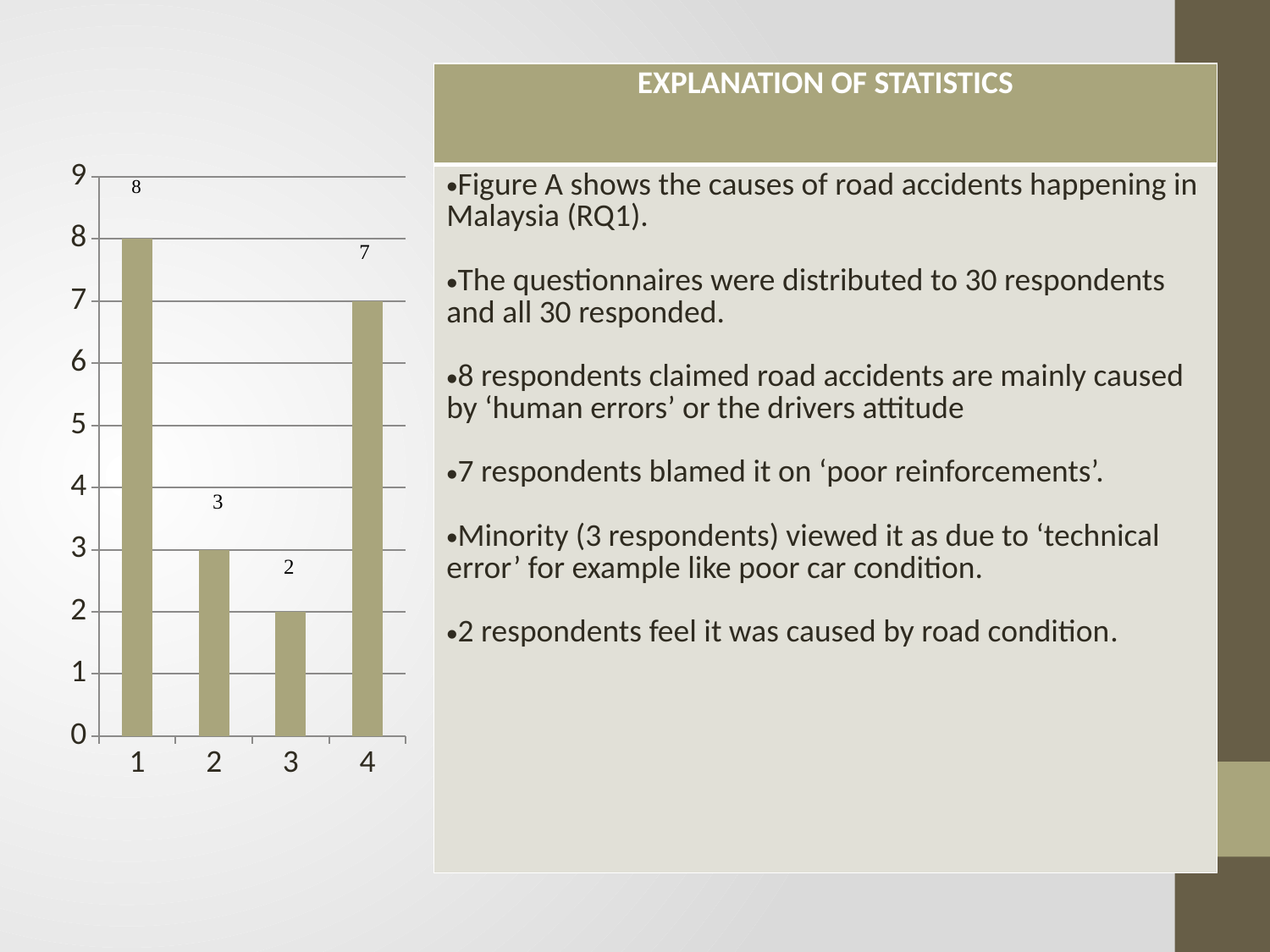
Which category has the highest value? 1 What is the value for category 3? 2 What is the difference between the values for category 2 and category 3? 1 What is the value for category 1? 8 What is the difference between the values for category 1 and category 4? 1 What kind of chart is shown on the slide? bar chart How many categories are shown on the x axis? 4 Which category has the lowest value? 3 What is the value for category 4? 7 Which is larger, the value for category 2 or the value for category 4? 4 Is the value for category 4 greater or less than 5? greater What is the highest value shown on the y axis? 9